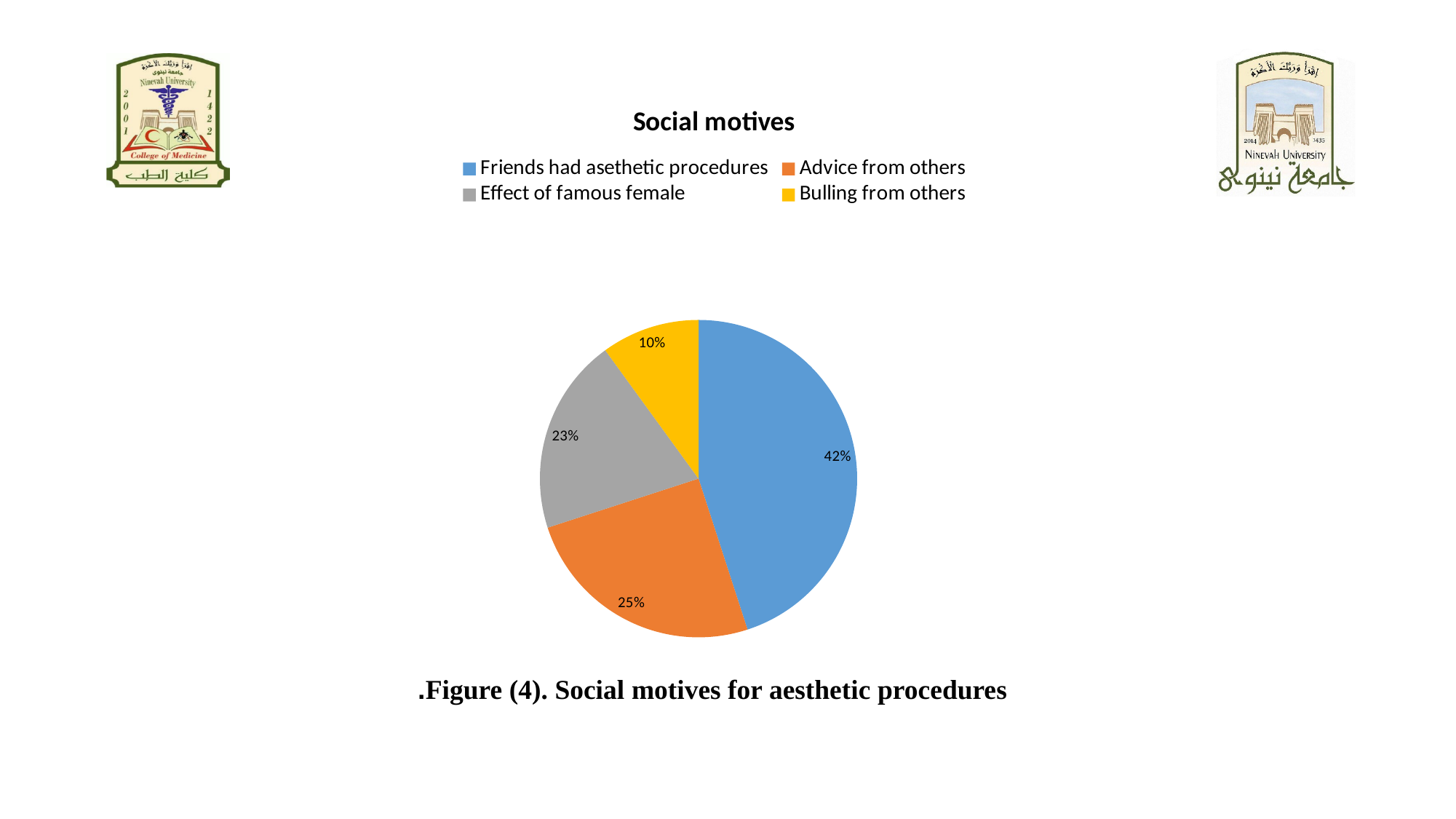
How many slices does the pie chart have? 4 Which social motive has the largest share of the pie? Friends had asethetic procedures Which is larger: the share for 'Effect of famous female' or the share for 'Bulling from others'? Effect of famous female Which colour represents 'Bulling from others' in the pie chart? yellow What share of the pie is 'Effect of famous female'? 23% What share of the pie is 'Friends had asethetic procedures'? 42% What type of chart is shown on the slide? pie chart What share of the pie is 'Bulling from others'? 10% Which social motive has the smallest share of the pie? Bulling from others What is the title of the chart? Social motives What is the difference in percentage points between 'Friends had asethetic procedures' and 'Advice from others'? 17